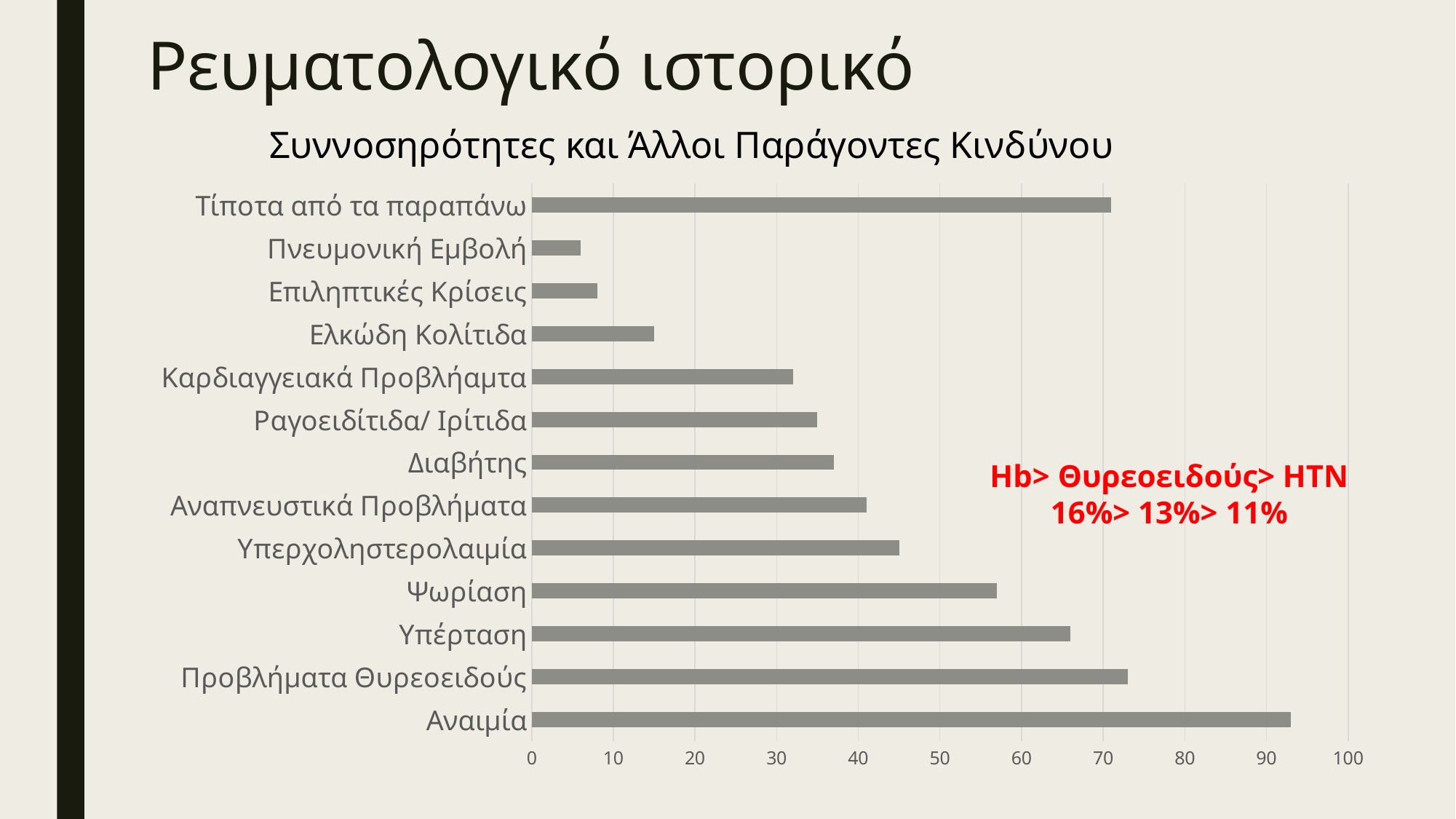
Which category has the highest value in the chart? Αναιμία Is the value for Υπέρταση greater or less than 70? less Is the value for Τίποτα από τα παραπάνω greater or less than 80? less Which has a larger value, Υπέρταση or Ψωρίαση? Υπέρταση Is the value for Αναιμία greater or less than 90? greater Which has a larger value, Ελκώδη Κολίτιδα or Επιληπτικές Κρίσεις? Ελκώδη Κολίτιδα What is the title of the chart? Συννοσηρότητες και Άλλοι Παράγοντες Κινδύνου How many categories are plotted in the chart? 13 What type of chart is shown on the slide? Bar chart